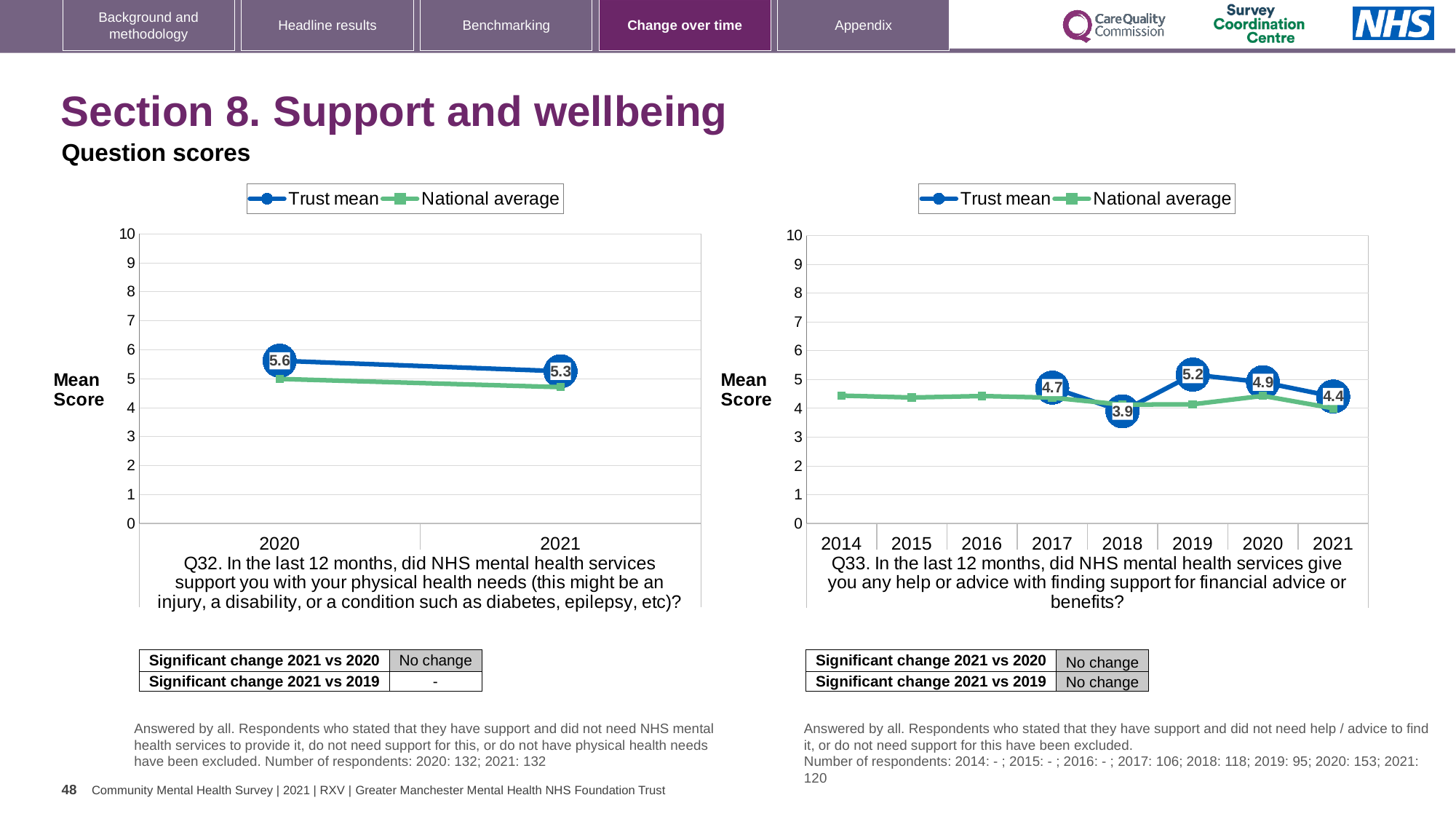
In the Q33 chart on the right, what is the difference between the Trust mean in 2019 and in 2018? 1.3 In the Q33 chart on the right, is the National average for 2014 greater or less than 5? less In the Q33 chart on the right, which year has the lowest Trust mean? 2018 In the Q32 chart on the left, does the Trust mean rise or fall from 2020 to 2021? fall In the Q33 chart on the right, what is the Trust mean for 2018? 3.9 In the Q33 chart on the right, which year has the highest Trust mean? 2019 In the Q32 chart on the left, what is the Trust mean for 2020? 5.6 In the Q33 chart on the right, what is the Trust mean for 2019? 5.2 In the Q33 chart on the right, is the Trust mean for 2020 higher or lower than for 2021? higher In the Q32 chart on the left, what is the Trust mean for 2021? 5.3 How many series does the legend of the Q33 chart on the right list? 2 In the Q32 chart on the left, by how much did the Trust mean change from 2020 to 2021? 0.3